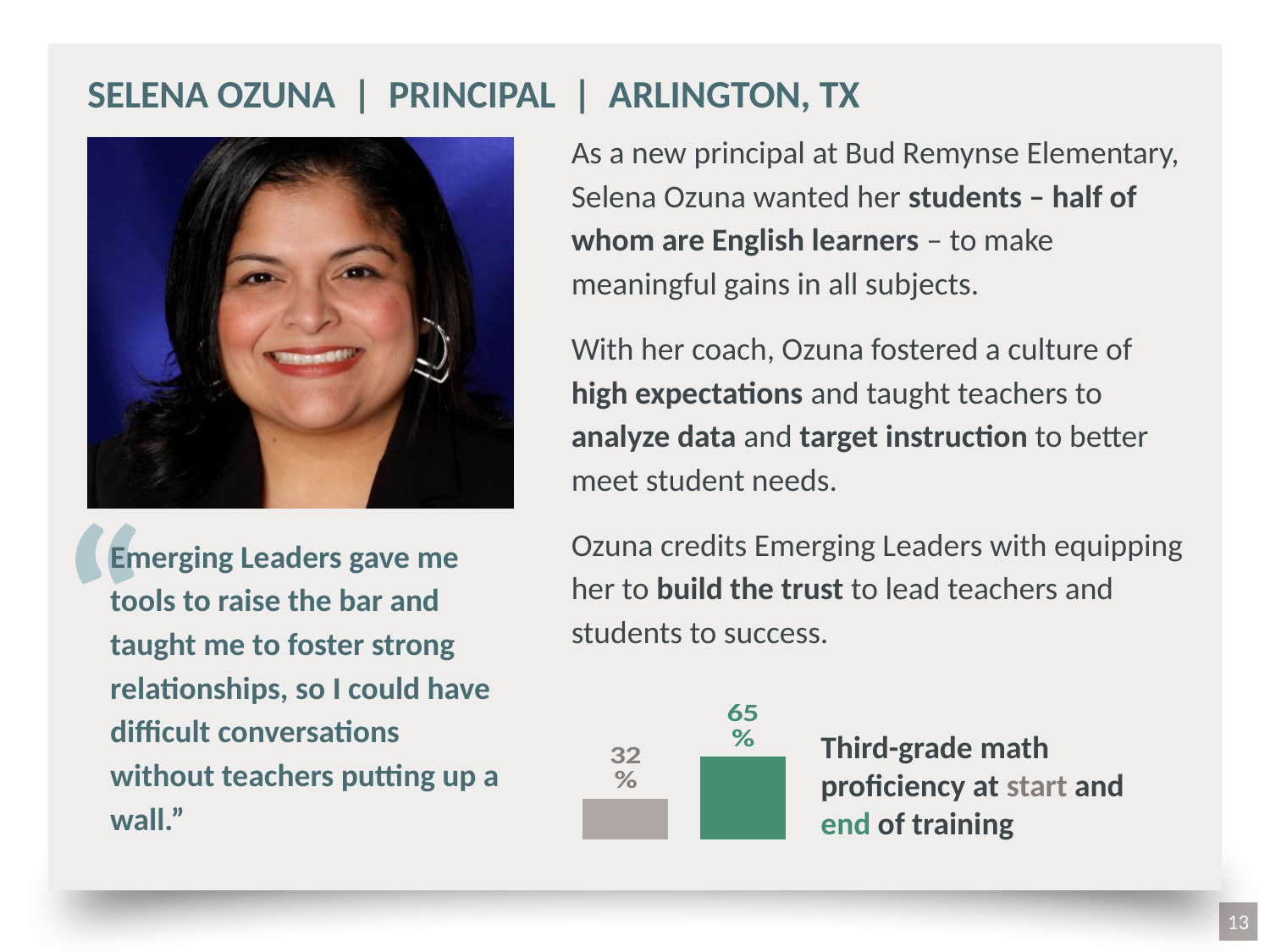
What colour is the bar for the end of training? green Which bar is lower, start or end of training? start By how many percentage points did third-grade math proficiency increase from start to end of training? 33 What was third-grade math proficiency at the end of training? 65% What was third-grade math proficiency at the start of training? 32% What subject and grade does the chart measure proficiency in? Third-grade math Is the end-of-training proficiency larger or smaller than the start-of-training proficiency? larger What kind of chart is shown on the slide? bar chart Which bar is higher, start or end of training? end Does third-grade math proficiency rise or fall from start to end of training? rise How many bars does the chart show? 2